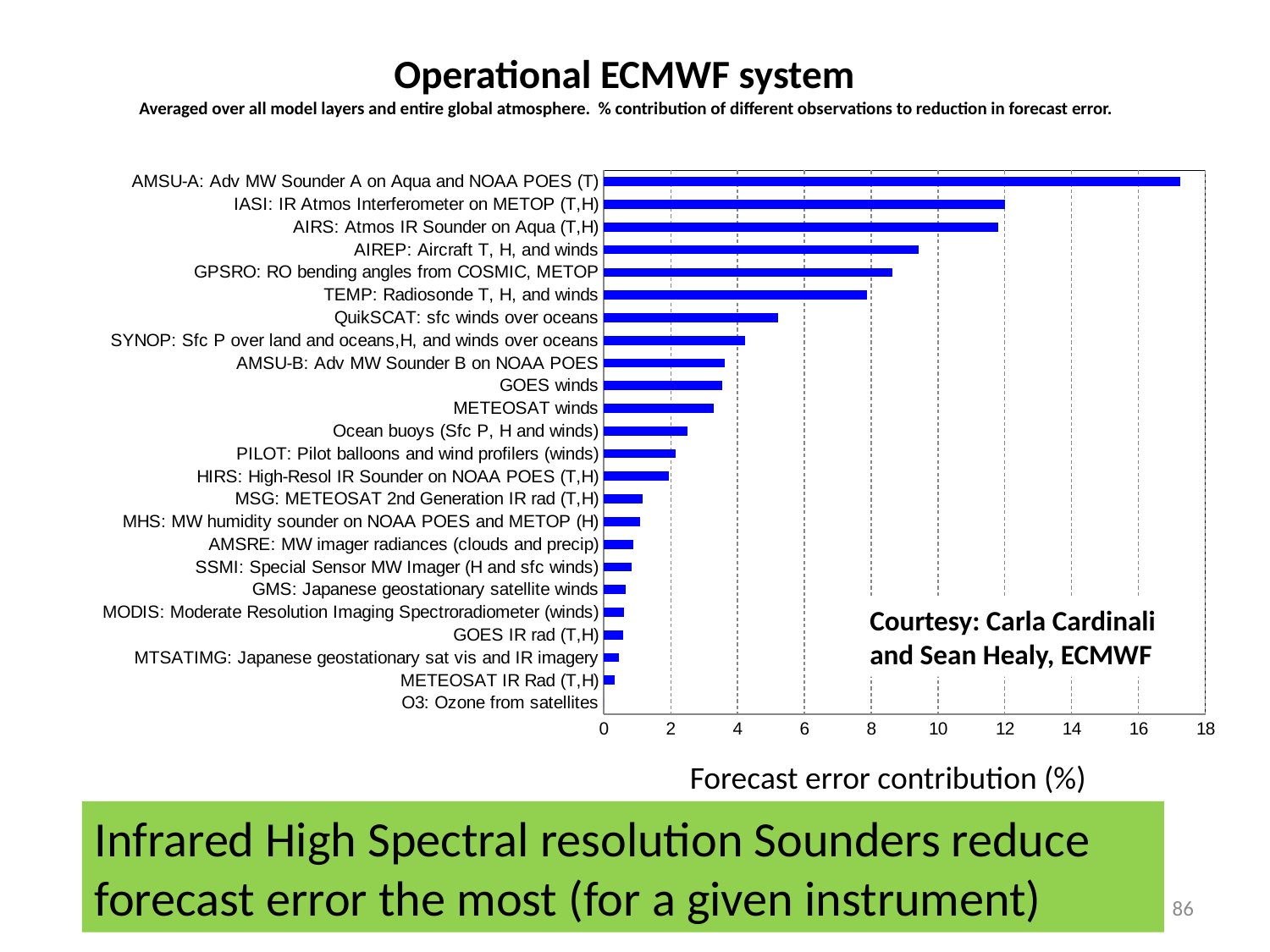
Which has a larger forecast error contribution, AIREP: Aircraft T, H, and winds or TEMP: Radiosonde T, H, and winds? AIREP: Aircraft T, H, and winds Is the forecast error contribution for AIREP: Aircraft T, H, and winds greater or less than 8? greater Which has a larger forecast error contribution, QuikSCAT: sfc winds over oceans or GOES winds? QuikSCAT: sfc winds over oceans How many observation types are listed on the chart? 24 What kind of chart is shown on the slide? bar chart Is the forecast error contribution for QuikSCAT: sfc winds over oceans greater or less than 4? greater Is the forecast error contribution for AMSU-B: Adv MW Sounder B on NOAA POES greater or less than 4? less What is the label of the horizontal axis of the chart? Forecast error contribution (%) Which observation type has the lowest forecast error contribution? O3: Ozone from satellites Which observation type has the highest forecast error contribution? AMSU-A: Adv MW Sounder A on Aqua and NOAA POES (T)